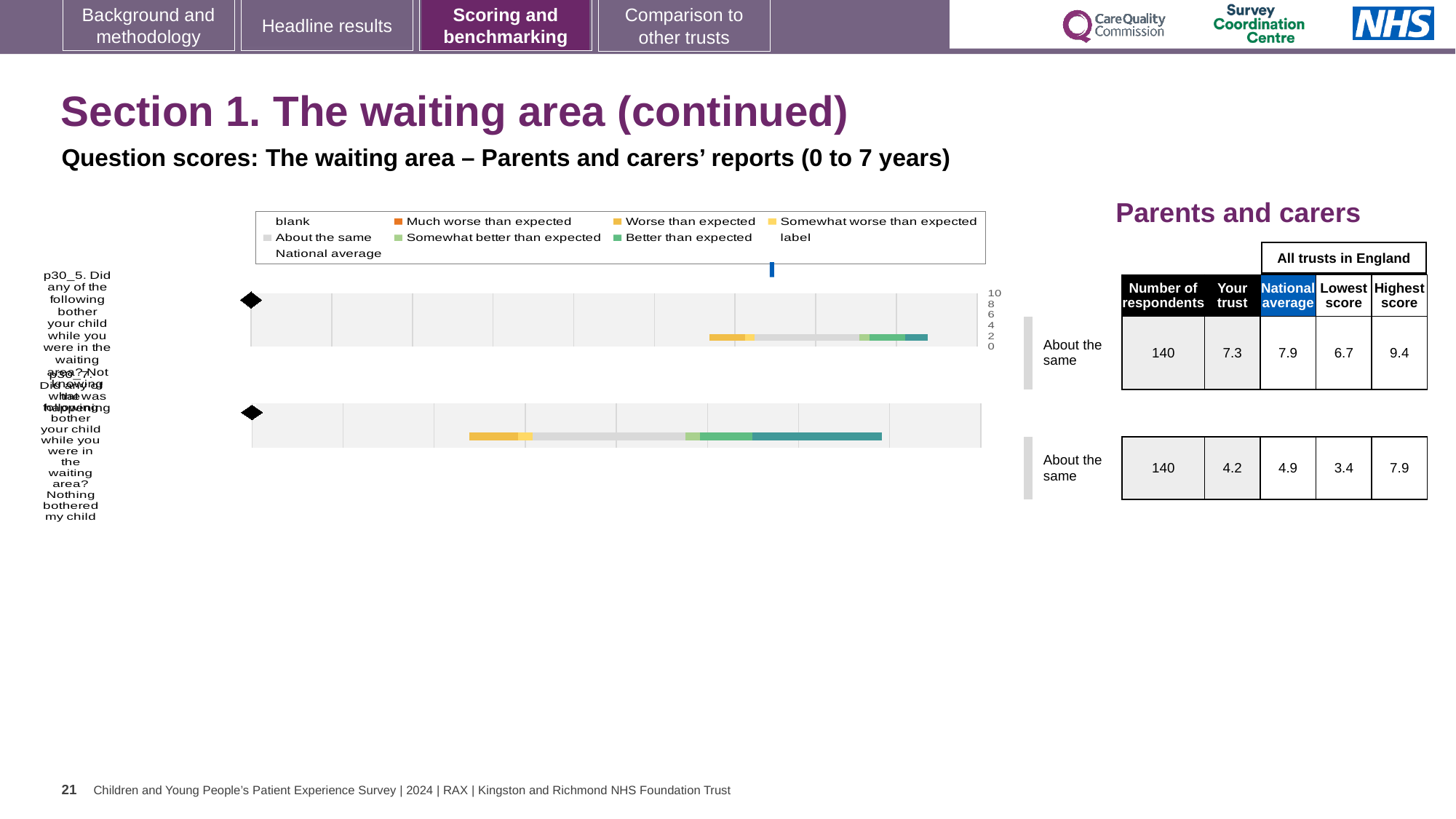
What benchmark category is shown for both questions next to the chart? About the same In the table beside the chart, what is the lowest score for the second question (p30_7)? 3.4 How many respondents are shown for each question in the table? 140 In the table beside the chart, what is the difference between the highest score and the lowest score for the first question (p30_5)? 2.7 How many entries does the chart legend list? 9 For the first question (p30_5), which is larger: the 'Your trust' score or the national average? National average How many questions (bars) are plotted in the chart? 2 What colour does the legend use for 'Much worse than expected'? orange What kind of chart is used to show the question scores on this slide? bar chart In the table beside the chart, what is the 'Your trust' score for the first question (p30_5)? 7.3 Which question has the higher 'Your trust' score, p30_5 or p30_7? p30_5 In the table beside the chart, what is the national average for the second question (p30_7)? 4.9